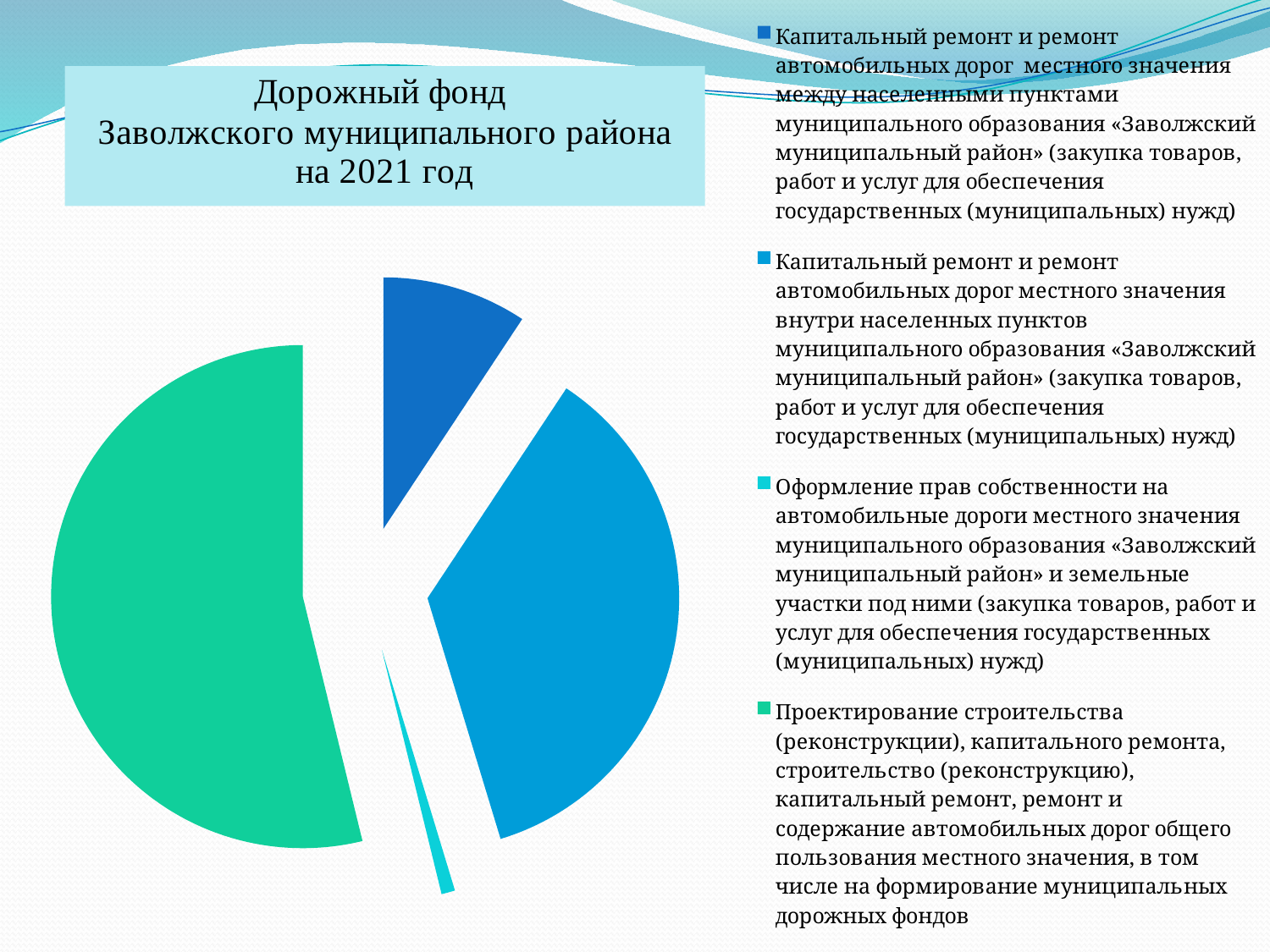
Which category takes the smallest share of the pie chart? Оформление прав собственности на автомобильные дороги местного значения муниципального образования «Заволжский муниципальный район» и земельные участки под ними How many entries does the legend of the pie chart list? 4 What is the title of the chart on the slide? Дорожный фонд Заволжского муниципального района на 2021 год How many slices does the pie chart have? 4 What kind of chart is shown on the slide? Pie chart Which slice is larger: the one for Проектирование строительства (реконструкции)... or the one for Капитальный ремонт и ремонт автомобильных дорог местного значения внутри населенных пунктов? Проектирование строительства (реконструкции)... What colour is the slice for Проектирование строительства (реконструкции)... in the pie chart? Green Which slice is larger: the one for Оформление прав собственности на автомобильные дороги or the one for Капитальный ремонт и ремонт автомобильных дорог местного значения между населенными пунктами? Капитальный ремонт и ремонт автомобильных дорог местного значения между населенными пунктами Which slice is larger: the one for repair of roads between settlements (между населенными пунктами) or the one for repair of roads inside settlements (внутри населенных пунктов)? Repair of roads inside settlements (внутри населенных пунктов)